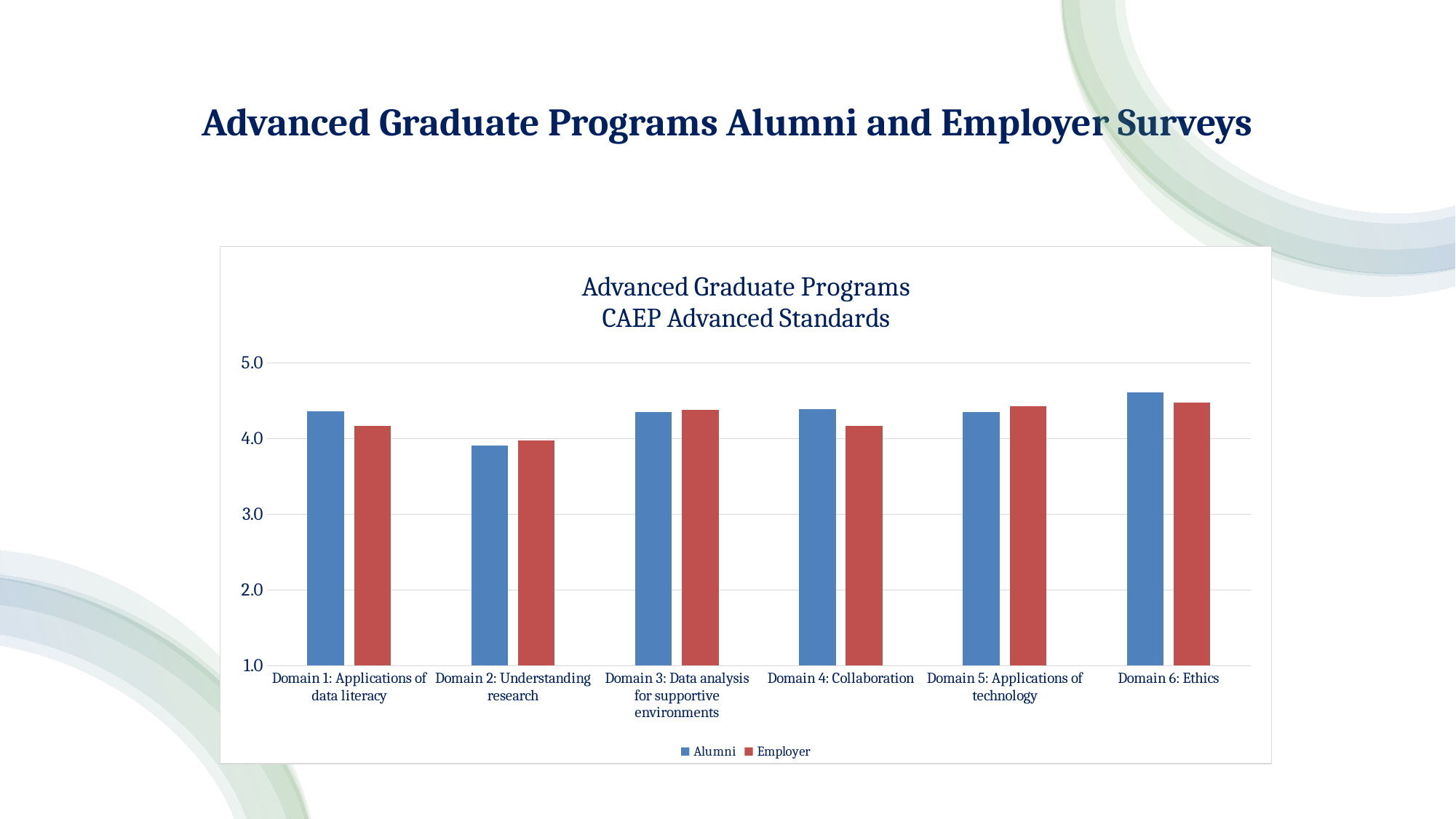
For Domain 1: Applications of data literacy, which is larger, the Alumni value or the Employer value? Alumni For Domain 4: Collaboration, which is larger, the Alumni value or the Employer value? Alumni Which domain has the highest Alumni value? Domain 6: Ethics Which domain has the lowest Alumni value? Domain 2: Understanding research How many domains (categories) are shown on the x axis of the chart? 6 Which colour represents the Employer series in the chart? Red What is the title of the chart? Advanced Graduate Programs CAEP Advanced Standards How many series does the chart's legend list? 2 What kind of chart is shown on the slide? Bar chart Is the Alumni value for Domain 2: Understanding research greater or less than 4.0? less Which domain has the lowest Employer value? Domain 2: Understanding research Is the Alumni value for Domain 6: Ethics greater or less than 4.0? greater